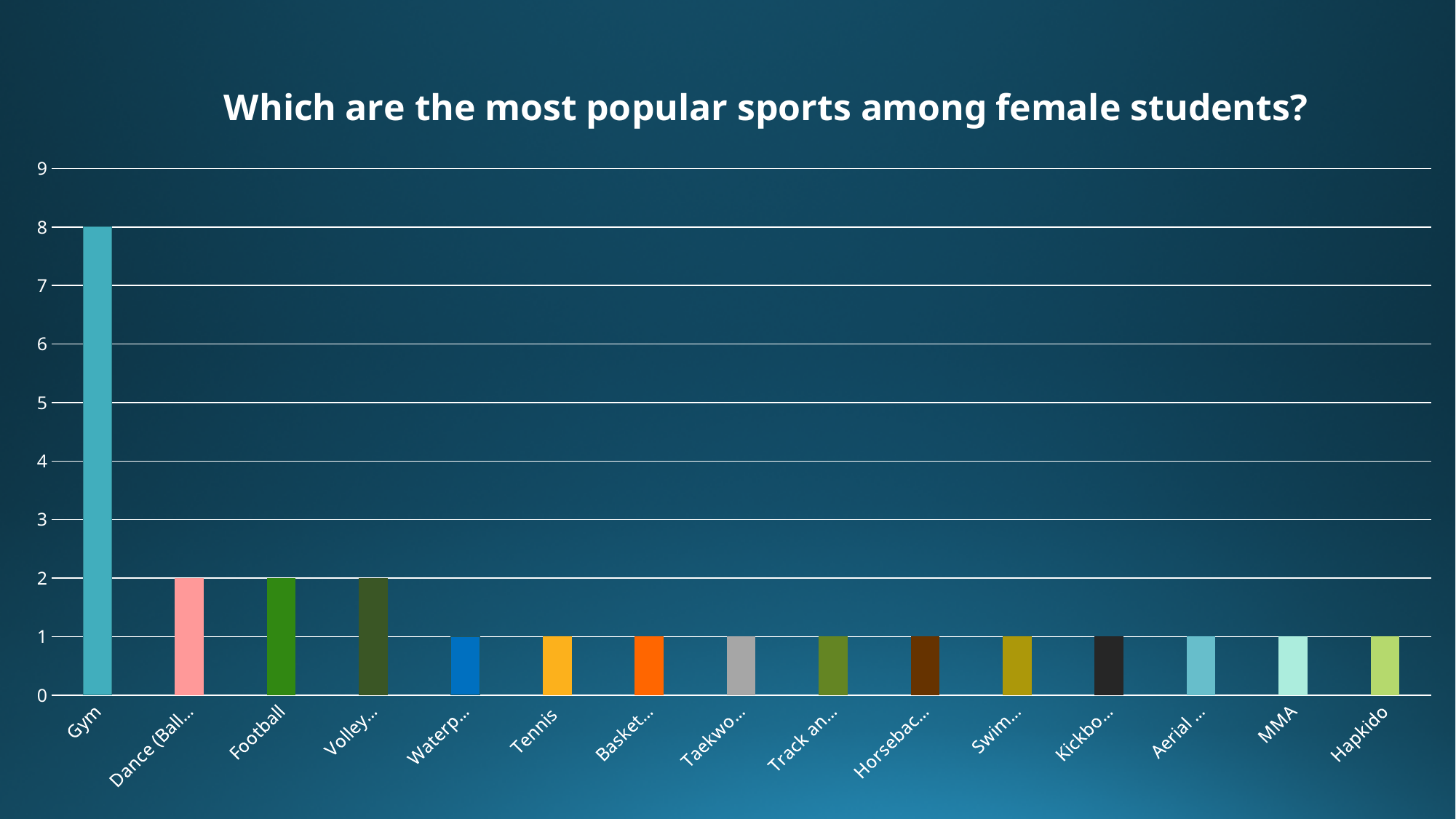
What type of chart is shown on the slide? bar chart What is the value for MMA? 1 Is the value for Gym greater or less than 5? greater What is the value for Hapkido? 1 What is the value for Tennis? 1 How many sports (bars) are shown in the chart? 15 What is the difference between the values for Gym and Football? 6 What is the title of the chart? Which are the most popular sports among female students? What is the value for Gym? 8 Which is larger, the value for Football or the value for Tennis? Football What is the value for Football? 2 Which sport has the highest value? Gym